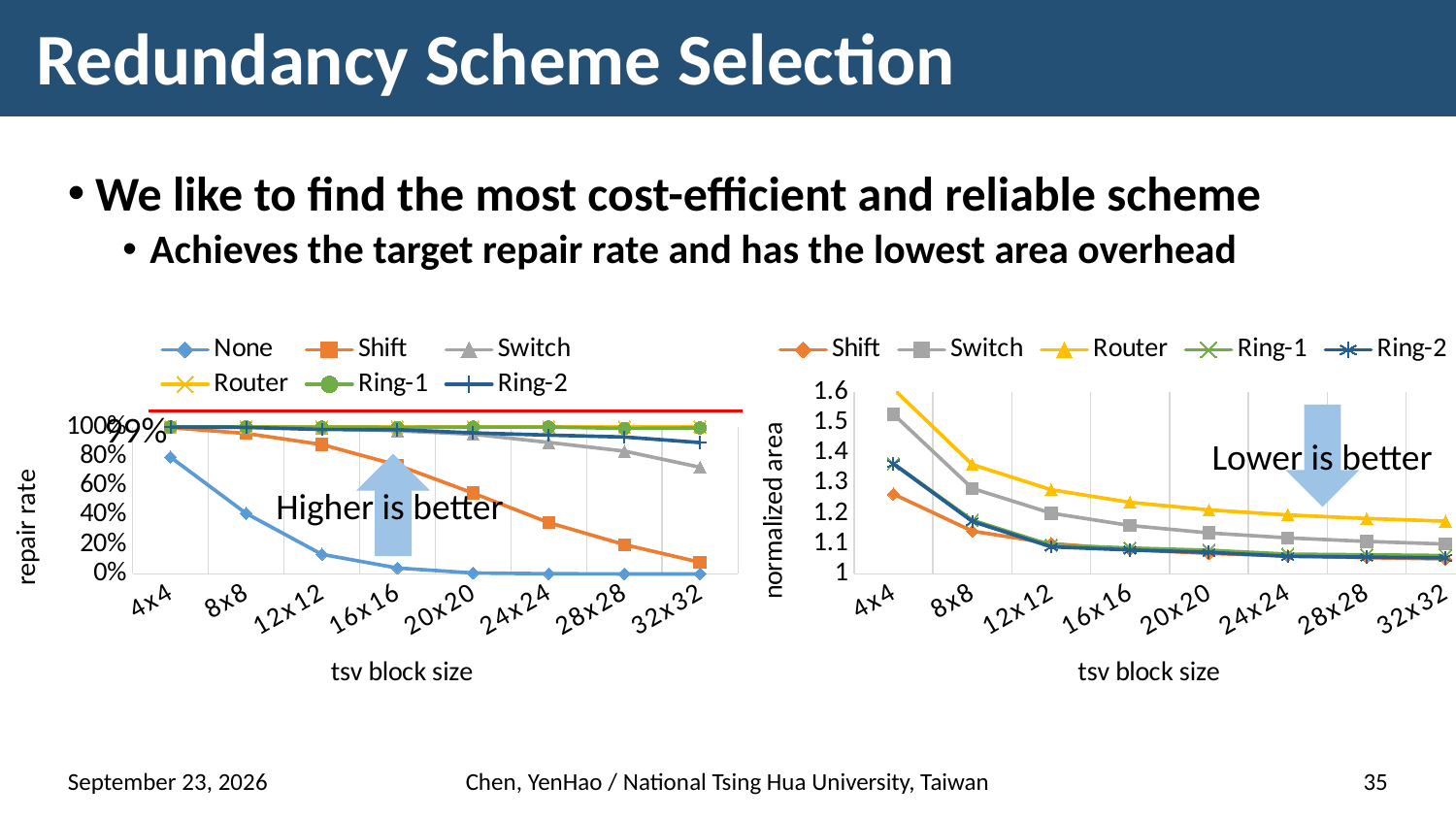
How many tsv block size categories are shown on the x axis of the right chart (normalized area)? 8 In the left chart (repair rate), is the value for Shift at 20x20 greater or less than 40%? greater How many series does the legend of the left chart (repair rate) list? 6 What kind of chart is the left chart showing repair rate? line chart In the right chart (normalized area), is the value for Shift at 4x4 greater or less than 1.2? greater In the right chart (normalized area), which is larger at 16x16: Router or Shift? Router In the left chart (repair rate), is the value for Switch at 32x32 greater or less than 60%? greater How many series does the legend of the right chart (normalized area) list? 5 In the left chart (repair rate), which series has the lowest value at 20x20? None In the right chart (normalized area), does the Router series rise or fall as tsv block size increases? fall In the right chart (normalized area), which series has the highest value at 4x4? Router